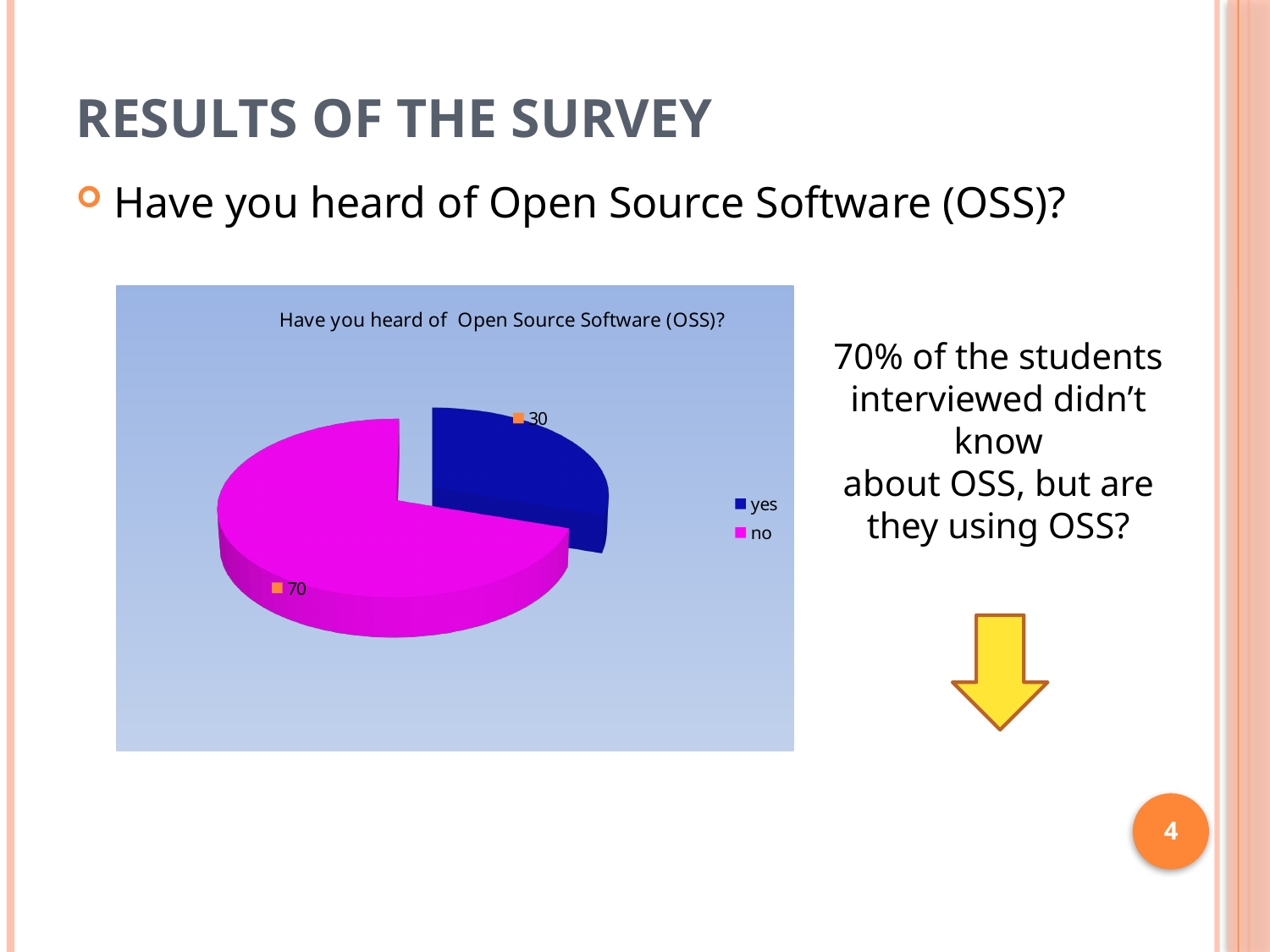
How many categories does the pie chart have? 2 Which is larger, the 'yes' slice or the 'no' slice? no What is the title of the chart? Have you heard of Open Source Software (OSS)? What type of chart is shown on the slide? pie chart What is the value of the 'no' slice? 70 Which category has the largest slice? no What colour is the 'yes' slice? blue What share of the pie does the 'no' slice represent? 70% What is the value of the 'yes' slice? 30 Which category has the smallest slice? yes How many entries does the legend list? 2 What is the difference between the 'no' and 'yes' values? 40